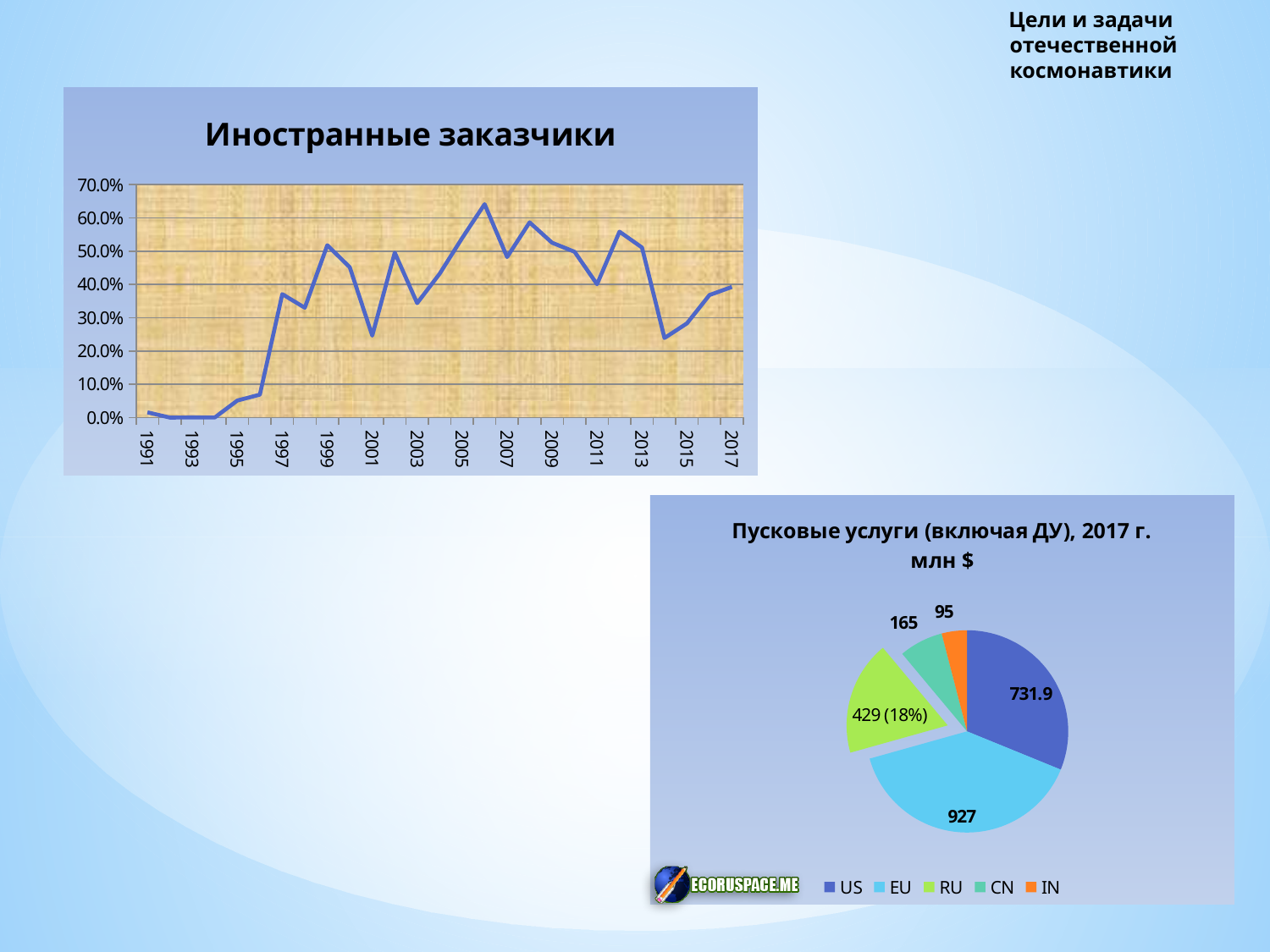
What kind of chart is "Иностранные заказчики"? line chart In the "Иностранные заказчики" chart, do the values rise or fall from 1995 to 1997? rise In the "Пусковые услуги" pie chart, what is the value for US? 731.9 In the "Пусковые услуги" pie chart, what is the difference between the EU and US values? 195.1 In the "Иностранные заказчики" chart, is the value for 1991 greater or less than 10.0%? less In the "Иностранные заказчики" chart, is the value for 2006 greater or less than 60.0%? greater What kind of chart is "Пусковые услуги (включая ДУ), 2017 г. млн $"? pie chart How many categories does the legend of the "Пусковые услуги" pie chart list? 5 In the "Иностранные заказчики" chart, is the value for 2001 greater or less than 30.0%? less In the "Пусковые услуги" pie chart, which category has the largest value? EU In the "Иностранные заказчики" chart, which year has the highest value? 2006 In the "Пусковые услуги" pie chart, which category has the smallest value? IN